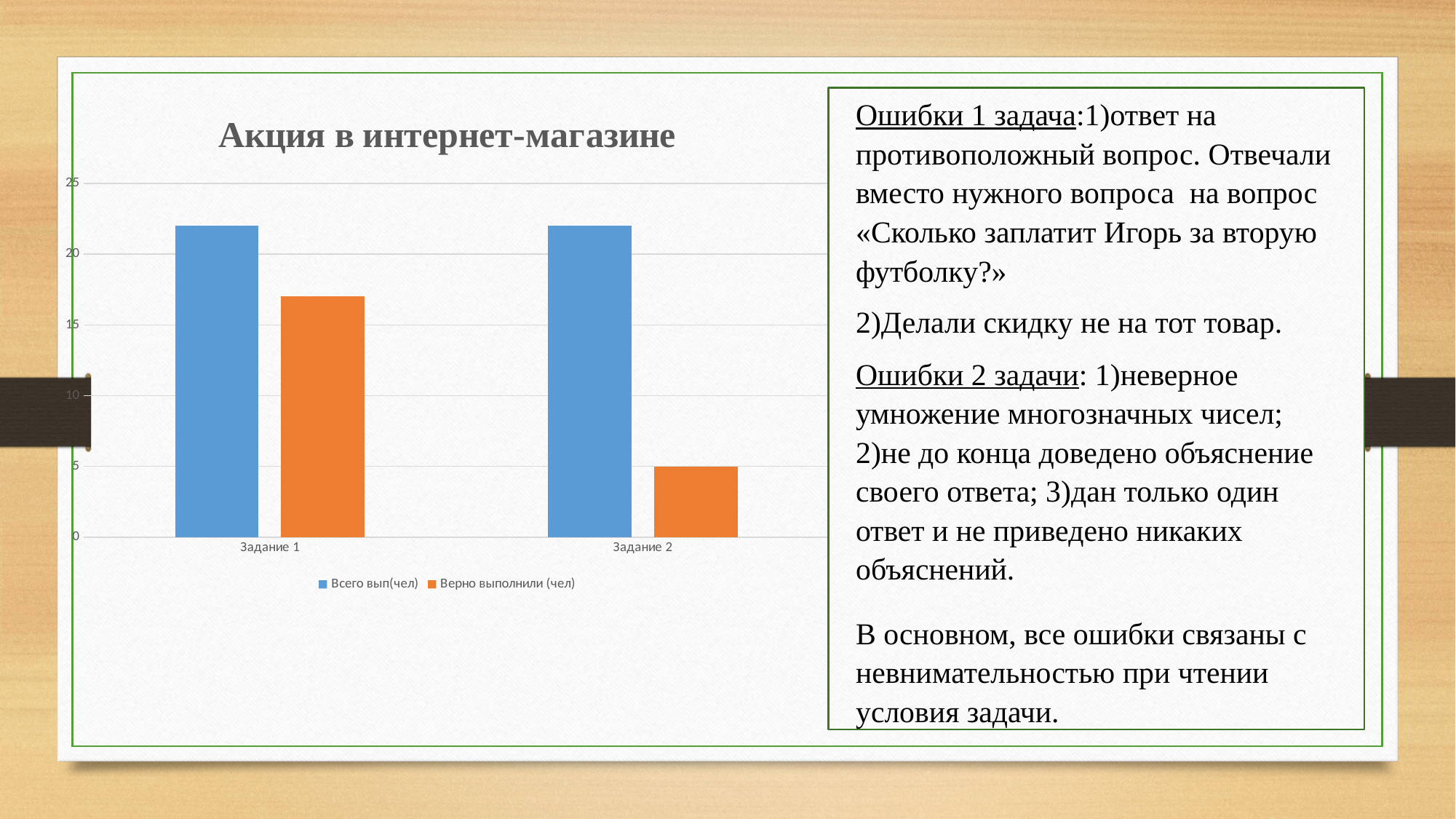
How many categories are shown on the x axis of the chart? 2 Is the value of Всего вып(чел) for Задание 2 greater or less than 25? less How many series does the chart legend list? 2 What is the title of the chart? Акция в интернет-магазине For Задание 2, which is larger: Всего вып(чел) or Верно выполнили (чел)? Всего вып(чел) Is the value of Верно выполнили (чел) for Задание 2 greater or less than 10? less Which category has the lower value for Верно выполнили (чел)? Задание 2 Which series is shown in orange in the chart? Верно выполнили (чел) Is the value of Всего вып(чел) for Задание 1 greater or less than 20? greater Which category has the higher value for Верно выполнили (чел)? Задание 1 What kind of chart is shown on the slide? Bar chart